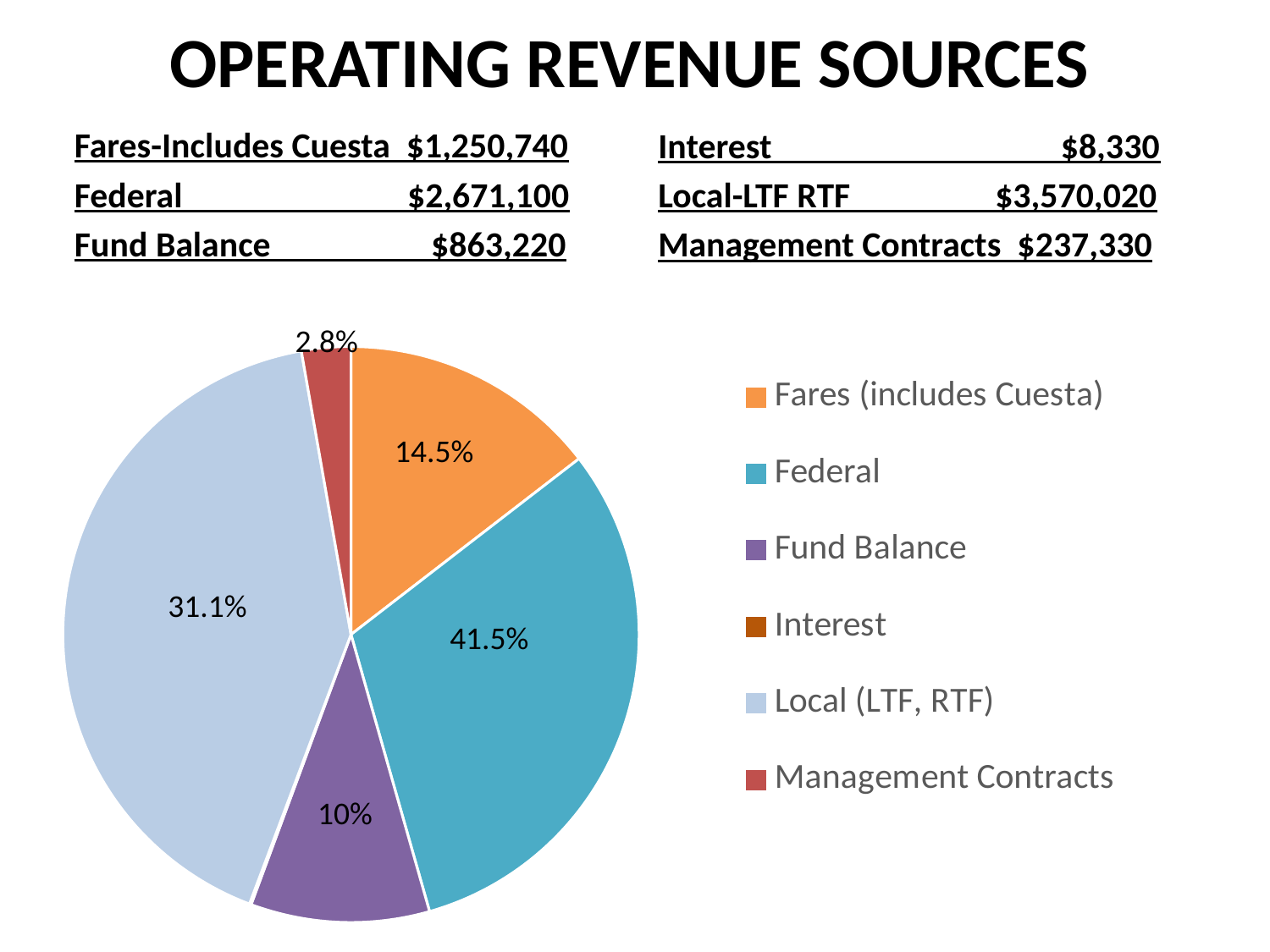
How many revenue sources are listed in the pie chart legend? 6 What share of the pie is labelled for Fares (includes Cuesta)? 14.5% What percentage is shown for the Management Contracts slice? 2.8% Which is larger: the Local (LTF, RTF) slice or the Fares (includes Cuesta) slice? Local (LTF, RTF) What percentage is shown for the Fund Balance slice? 10% What is the title of the slide containing the pie chart? OPERATING REVENUE SOURCES What type of chart is shown on the slide? Pie chart Which revenue source has the largest slice of the pie? Local (LTF, RTF)